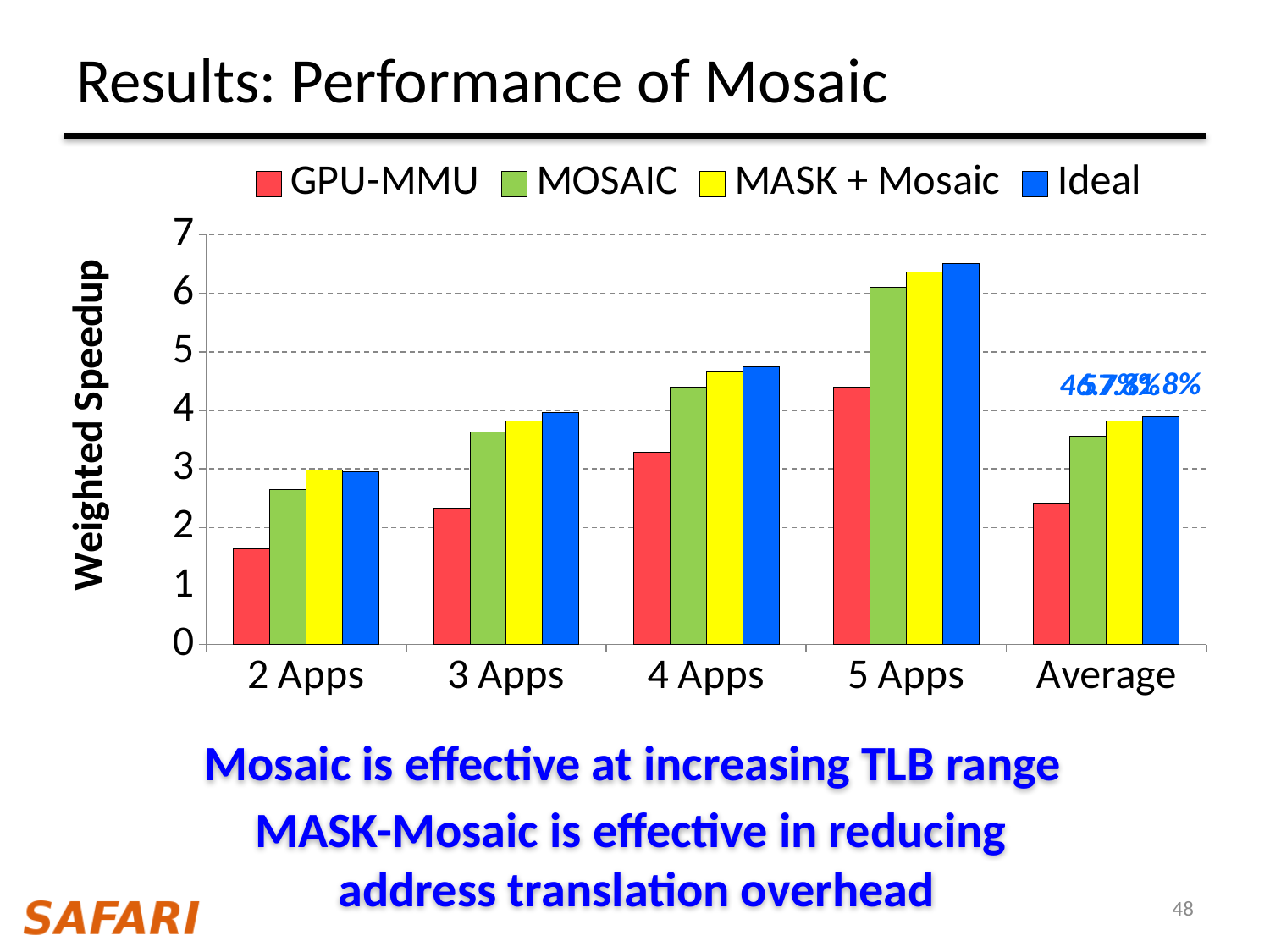
What is the label of the y axis? Weighted Speedup How many series does the legend list? 4 Is the GPU-MMU value for 2 Apps greater or less than 2? less For which category is the GPU-MMU value lowest? 2 Apps Is the MOSAIC value for 5 Apps greater or less than 6? greater Is the GPU-MMU value for 5 Apps greater or less than 4? greater Which series is shown in blue in the legend? Ideal What kind of chart is shown on the slide? bar chart How many categories are shown along the x axis? 5 For which category is the Ideal value highest? 5 Apps Does the GPU-MMU value rise or fall from 2 Apps to 5 Apps? rise